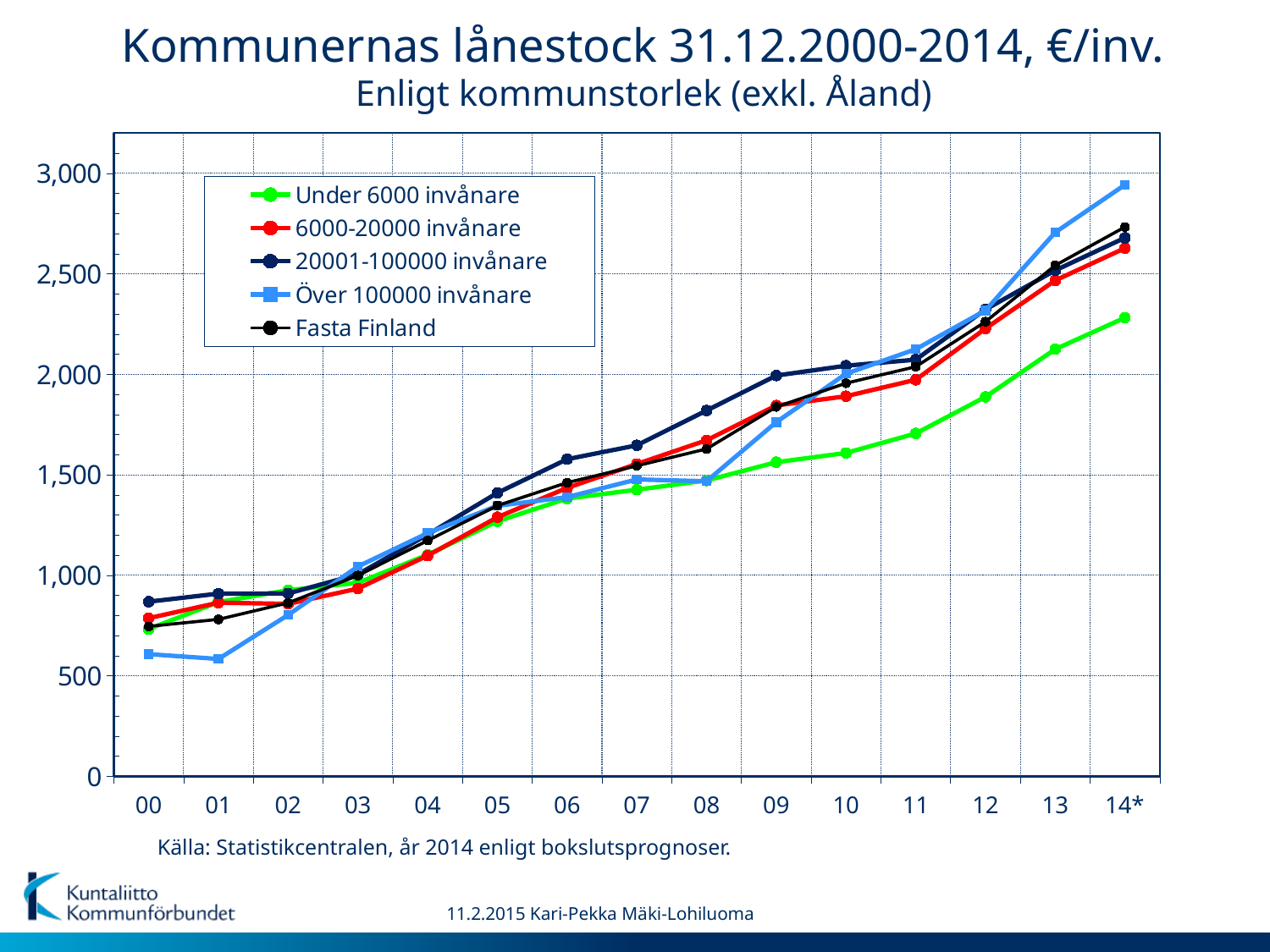
What kind of chart is shown on the slide? line chart How many years are plotted along the x axis? 15 Does the Under 6000 invånare series generally rise or fall from 00 to 14*? rise Which series has the highest value in 14*? Över 100000 invånare In 09, which is larger: Under 6000 invånare or 20001-100000 invånare? 20001-100000 invånare Is the value for Under 6000 invånare in 14* greater or less than 2,500? less How many series does the legend list? 5 Is the value for 6000-20000 invånare in 05 greater or less than 1,500? less Which series has the lowest value in 00? Över 100000 invånare Is the value for Över 100000 invånare in 00 greater or less than 1,000? less Which series has the lowest value in 14*? Under 6000 invånare